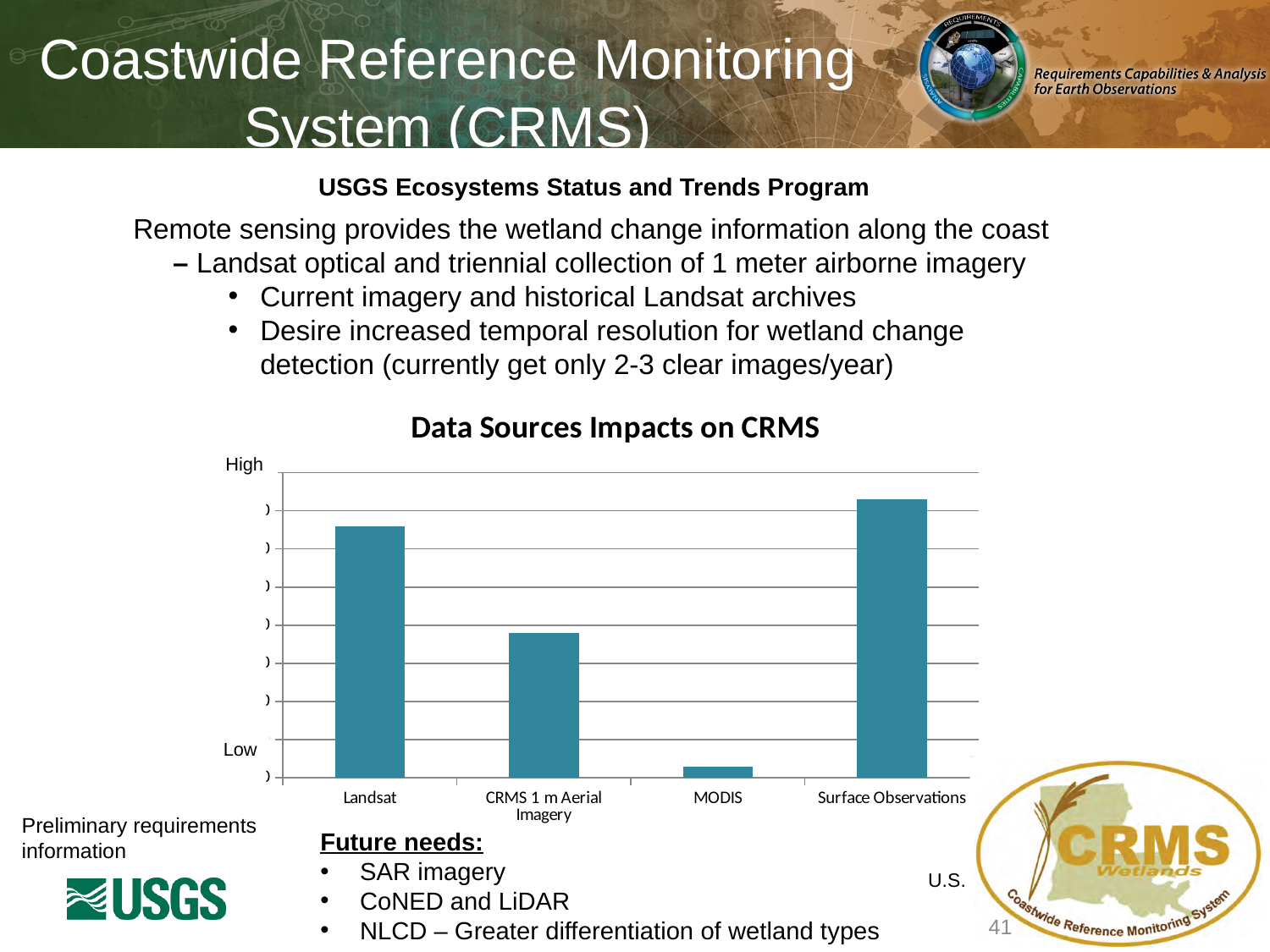
Which has a larger value in the chart, Surface Observations or Landsat? Surface Observations Which data source has the lowest impact on CRMS in the chart? MODIS What is the title of the chart on the slide? Data Sources Impacts on CRMS Which data source has the highest impact on CRMS in the chart? Surface Observations How many data sources (categories) are plotted in the chart? 4 Which has a larger value in the chart, Landsat or CRMS 1 m Aerial Imagery? Landsat What are the two labels shown at the top and bottom of the chart's vertical axis? High and Low What type of chart is shown on the slide? bar chart Which has a larger value in the chart, MODIS or CRMS 1 m Aerial Imagery? CRMS 1 m Aerial Imagery Which category is plotted second from the left in the chart? CRMS 1 m Aerial Imagery